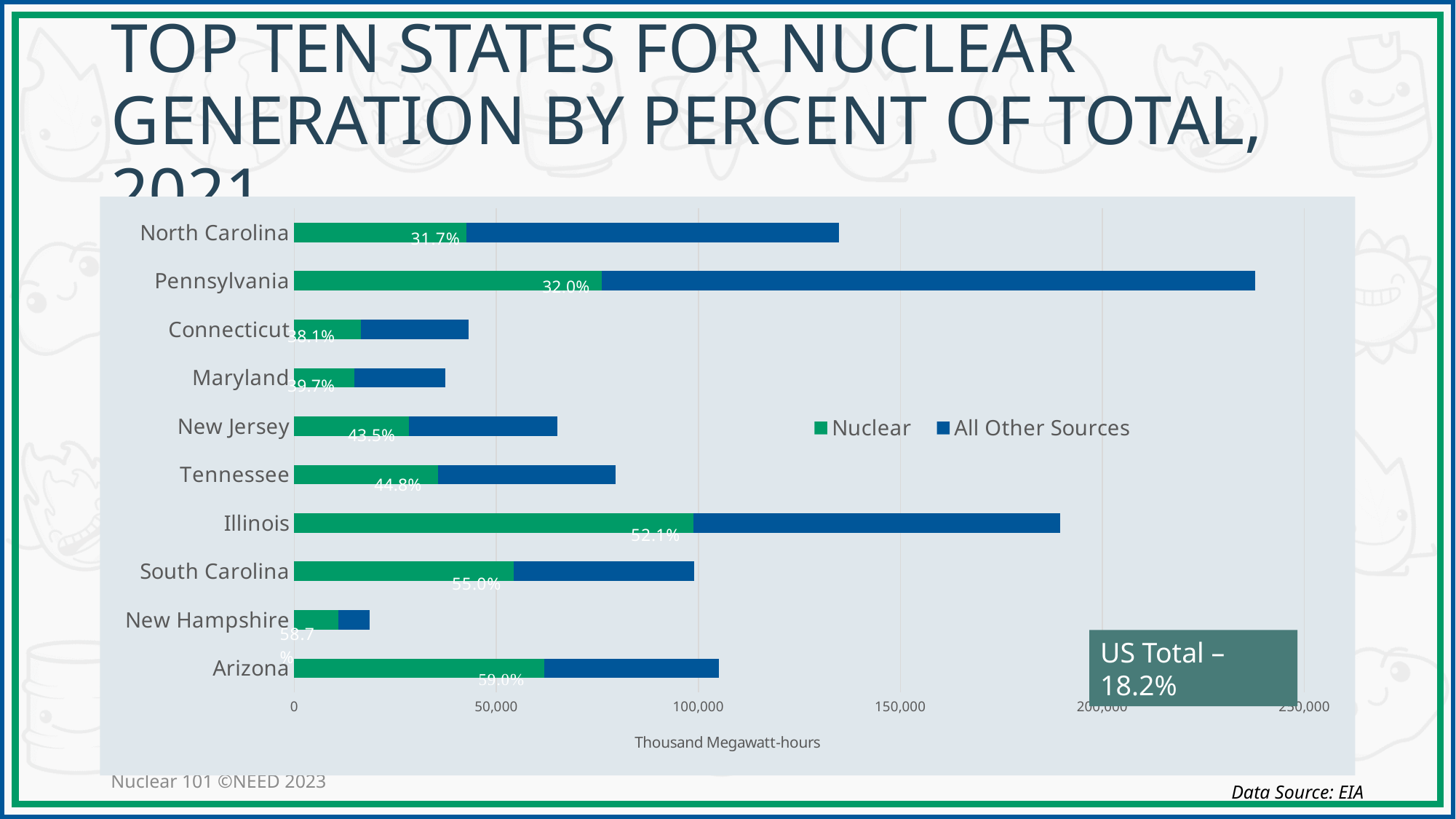
Which state has the lowest nuclear percentage label? North Carolina What is the nuclear percentage label shown for New Hampshire? 58.7% What is the difference in nuclear percentage between Arizona and North Carolina? 27.3 percentage points What kind of chart is shown on the slide? Stacked bar chart How many series does the legend list? 2 What US total nuclear percentage is shown in the box on the chart? 18.2% What percentage of total generation came from nuclear in Illinois? 52.1% Which state has the highest nuclear percentage label? Arizona Is the total generation bar for Pennsylvania greater or less than 200,000 thousand megawatt-hours? greater What is the nuclear percentage label shown for Pennsylvania? 32.0% How many states are shown in the chart? 10 Which state has the longer total bar, Pennsylvania or Illinois? Pennsylvania